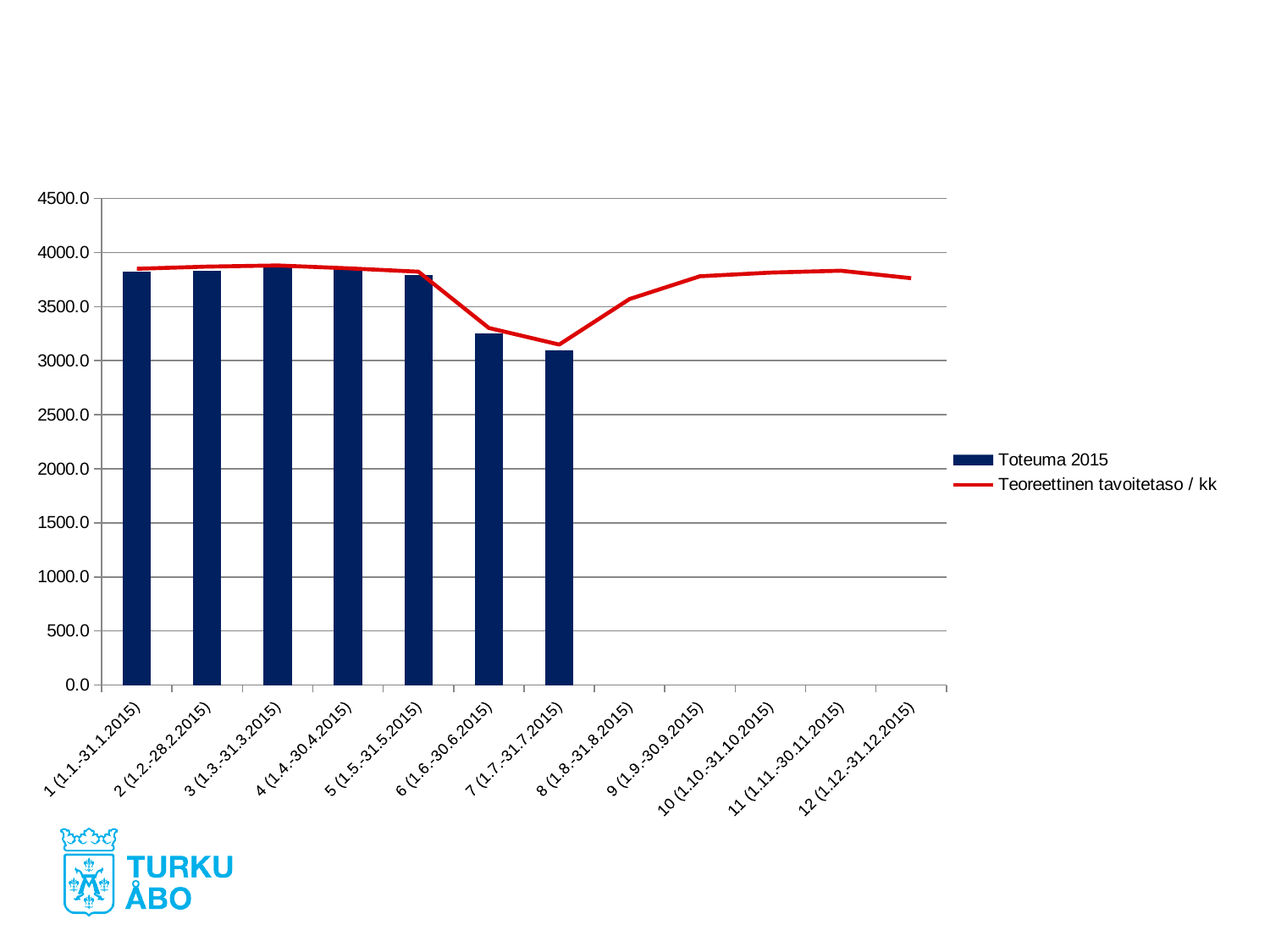
What colour is the Teoreettinen tavoitetaso / kk line? Red Is the Toteuma 2015 value for 6 (1.6.-30.6.2015) greater or less than 3000? greater Is the Toteuma 2015 value for 1 (1.1.-31.1.2015) greater or less than 3500? greater Do the Toteuma 2015 bars rise or fall from 5 (1.5.-31.5.2015) to 7 (1.7.-31.7.2015)? fall How many bars are plotted for the Toteuma 2015 series? 7 How many series does the legend list? 2 What kind of chart is this? A bar chart combined with a line chart Is the Toteuma 2015 value for 7 (1.7.-31.7.2015) greater or less than 3500? less Which is larger, the Toteuma 2015 value for 1 (1.1.-31.1.2015) or for 7 (1.7.-31.7.2015)? 1 (1.1.-31.1.2015) Which category has the lowest Toteuma 2015 bar? 7 (1.7.-31.7.2015) How many categories are shown on the x axis? 12 What are the two series named in the legend? Toteuma 2015 and Teoreettinen tavoitetaso / kk